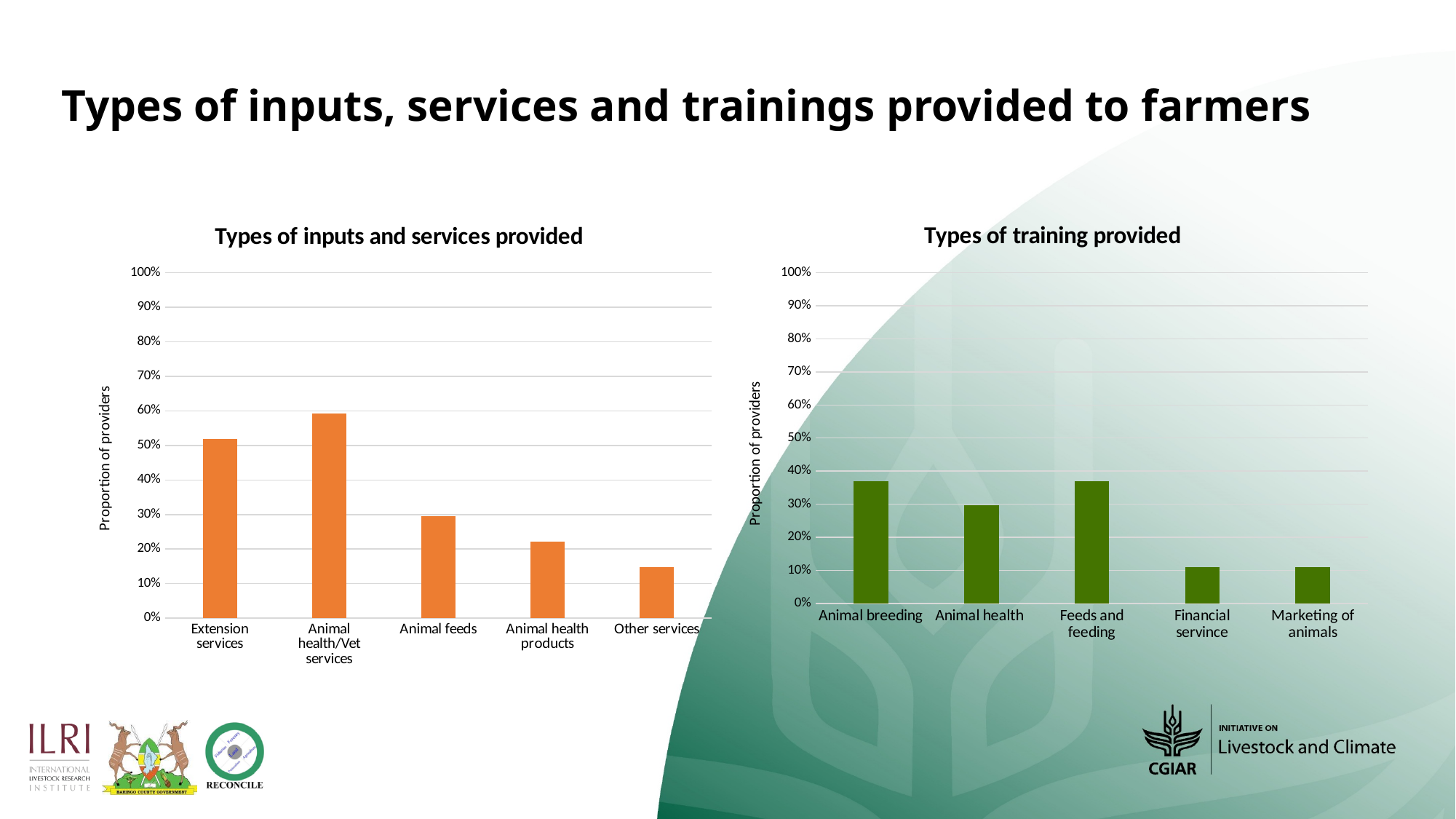
How many categories are shown in the 'Types of inputs and services provided' chart? 5 In the 'Types of inputs and services provided' chart, which category has the highest proportion of providers? Animal health/Vet services In the 'Types of inputs and services provided' chart, is the value for Extension services greater or less than 50%? greater In the 'Types of inputs and services provided' chart, is the value for Animal health products greater or less than 30%? less In the 'Types of training provided' chart, is the value for Animal breeding greater or less than 30%? greater In the 'Types of training provided' chart, which is larger: Animal health or Marketing of animals? Animal health What is the y-axis label of the 'Types of training provided' chart? Proportion of providers How many categories are shown in the 'Types of training provided' chart? 5 What kind of chart is the 'Types of inputs and services provided' chart? bar chart In the 'Types of inputs and services provided' chart, which is larger: Animal feeds or Animal health products? Animal feeds In the 'Types of inputs and services provided' chart, which category has the lowest proportion of providers? Other services